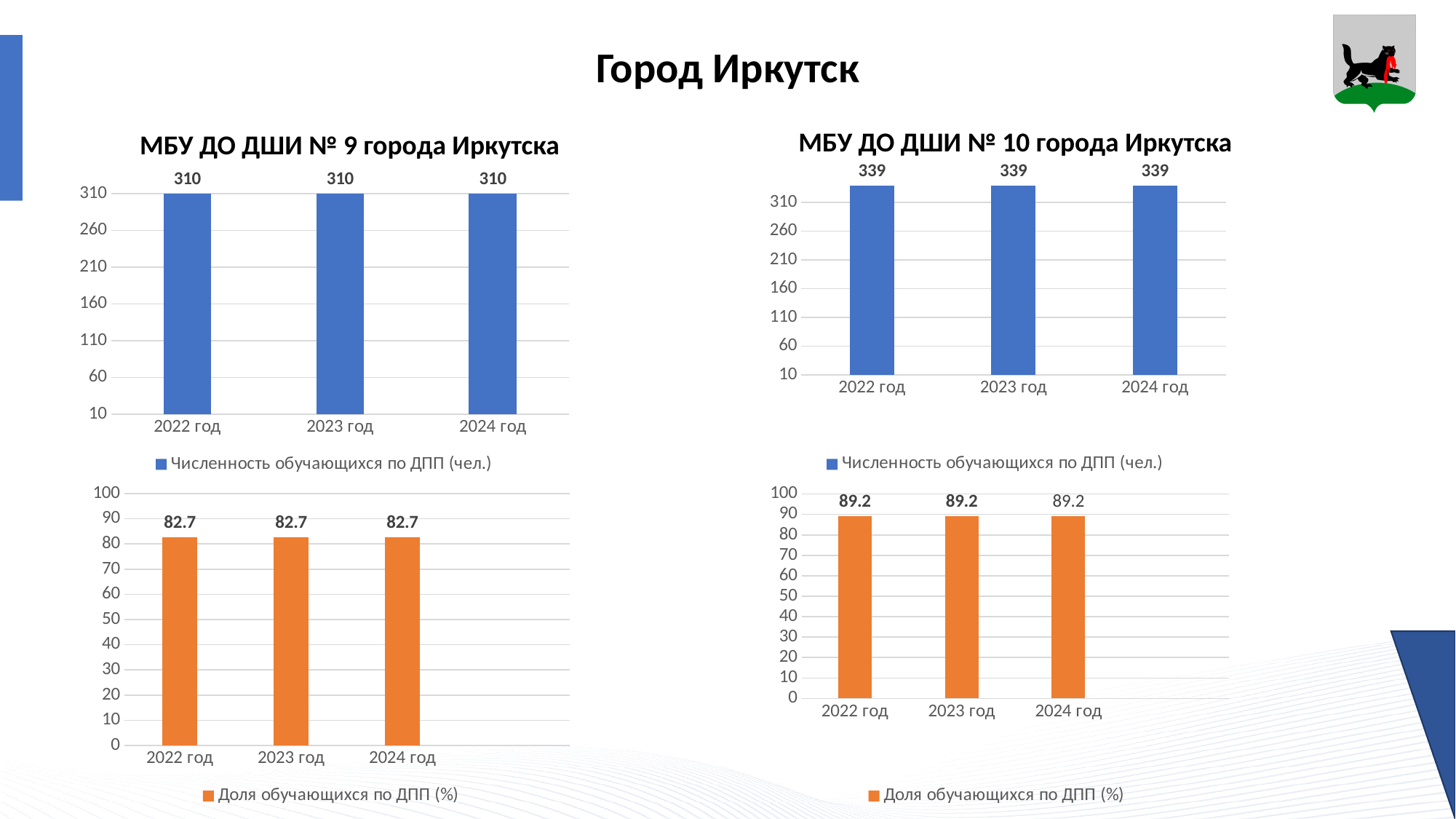
In the bottom chart under 'МБУ ДО ДШИ № 9 города Иркутска', what is the value for 2022 год? 82.7 In the bottom chart under 'МБУ ДО ДШИ № 10 города Иркутска', how many series does the legend list? 1 In the top chart under 'МБУ ДО ДШИ № 9 города Иркутска', how many categories are shown on the x axis? 3 Which is larger: the 2024 год value in the bottom chart for 'МБУ ДО ДШИ № 10 города Иркутска' or the 2024 год value in the bottom chart for 'МБУ ДО ДШИ № 9 города Иркутска'? МБУ ДО ДШИ № 10 города Иркутска In the bottom chart under 'МБУ ДО ДШИ № 9 города Иркутска', is the value for 2023 год greater or less than 90? less In the bottom chart under 'МБУ ДО ДШИ № 10 города Иркутска', what is the value for 2023 год? 89.2 What kind of chart is the top chart under 'МБУ ДО ДШИ № 10 города Иркутска'? bar chart In the top chart under 'МБУ ДО ДШИ № 10 города Иркутска', what is the value for 2024 год? 339 What is the difference between the 2022 год value in the top chart for 'МБУ ДО ДШИ № 10 города Иркутска' and the 2022 год value in the top chart for 'МБУ ДО ДШИ № 9 города Иркутска'? 29 In the bottom chart under 'МБУ ДО ДШИ № 9 города Иркутска', do the values rise, fall or stay the same from 2022 год to 2024 год? stay the same What is the legend entry of the bottom chart under 'МБУ ДО ДШИ № 10 города Иркутска'? Доля обучающихся по ДПП (%) In the top chart under 'МБУ ДО ДШИ № 9 города Иркутска', what is the value for 2023 год? 310